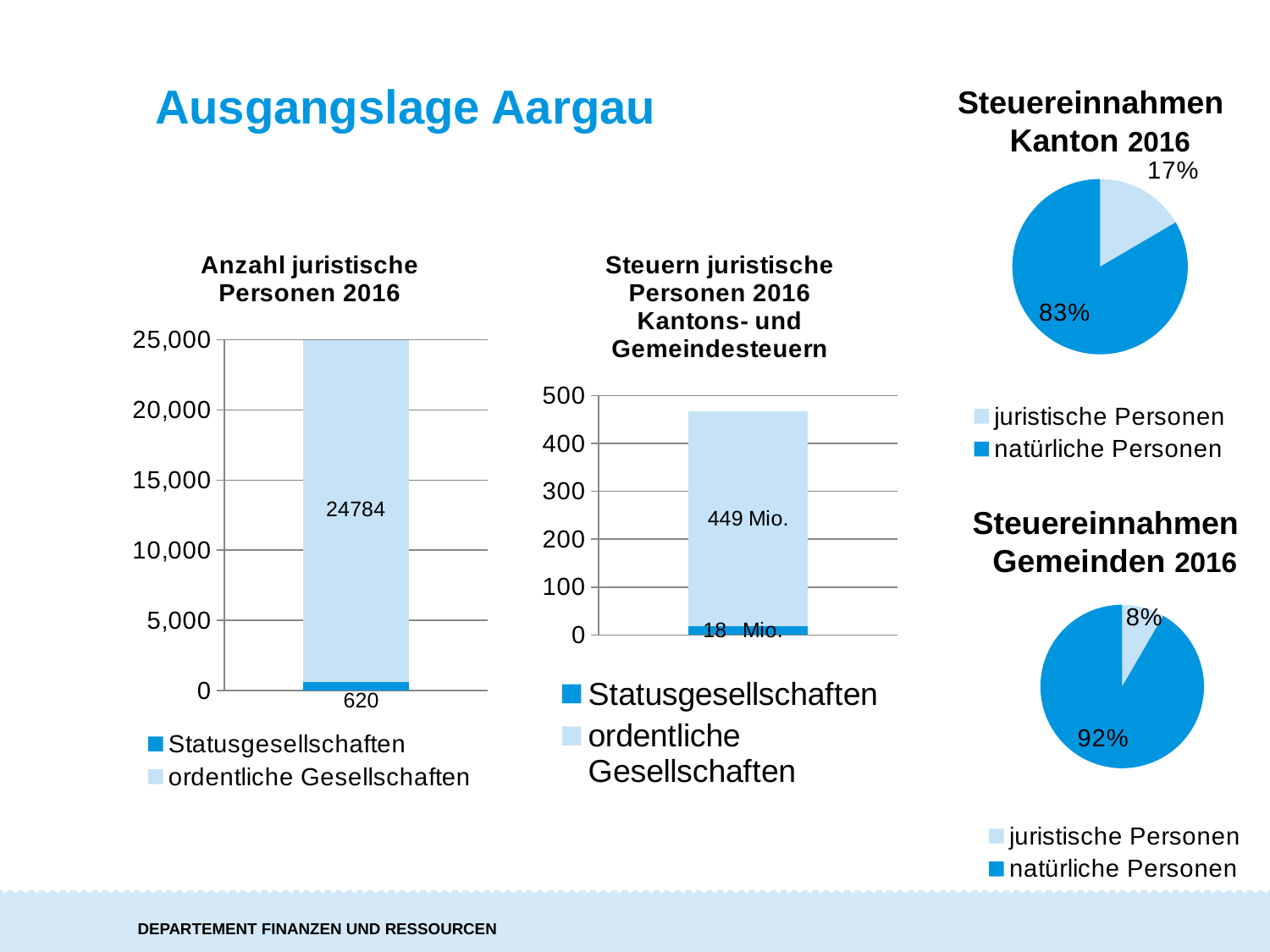
In the chart 'Steuern juristische Personen 2016 Kantons- und Gemeindesteuern', what is the value for Statusgesellschaften? 18 Mio. How many series does the legend of the chart 'Anzahl juristische Personen 2016' list? 2 In the chart 'Steuern juristische Personen 2016 Kantons- und Gemeindesteuern', what is the value for ordentliche Gesellschaften? 449 Mio. In the chart 'Anzahl juristische Personen 2016', what is the value for ordentliche Gesellschaften? 24784 In the pie chart 'Steuereinnahmen Kanton 2016', what share do natürliche Personen have? 83% In the chart 'Anzahl juristische Personen 2016', what is the total of the stacked bar? 25404 In the chart 'Steuern juristische Personen 2016 Kantons- und Gemeindesteuern', what is the difference between ordentliche Gesellschaften and Statusgesellschaften? 431 Mio. In the pie chart 'Steuereinnahmen Gemeinden 2016', what share do juristische Personen have? 8% In the pie chart 'Steuereinnahmen Kanton 2016', what share do juristische Personen have? 17% What kind of chart is 'Steuereinnahmen Kanton 2016'? pie chart In the pie chart 'Steuereinnahmen Gemeinden 2016', which slice is larger, juristische Personen or natürliche Personen? natürliche Personen In the chart 'Anzahl juristische Personen 2016', what is the value for Statusgesellschaften? 620